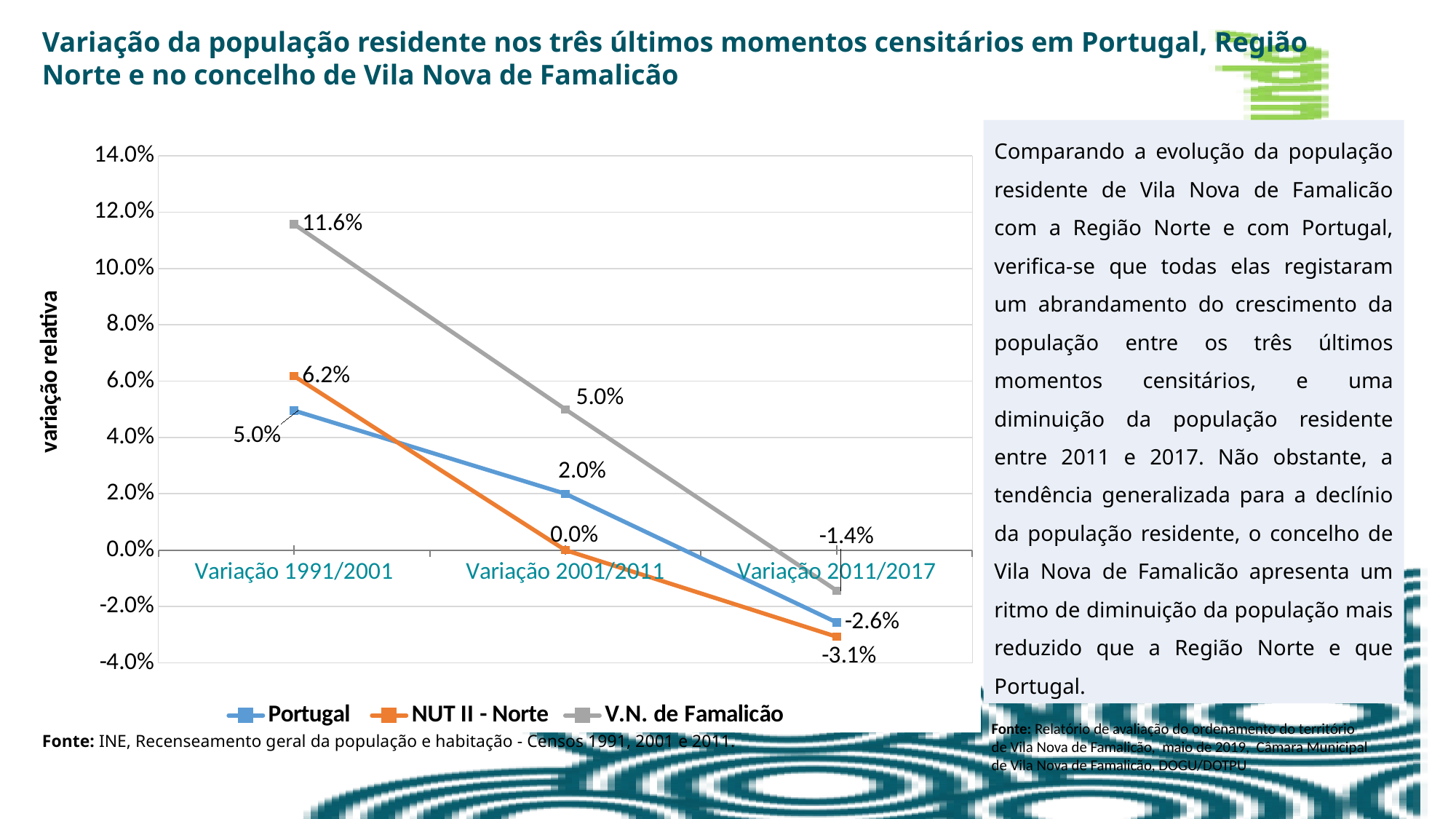
Which series has the highest value in Variação 1991/2001? V.N. de Famalicão Do the values for Portugal rise or fall across the three census periods? fall Which is larger in Variação 2001/2011: Portugal or V.N. de Famalicão? V.N. de Famalicão How many series does the legend list? 3 Which series has the lowest value in Variação 2011/2017? NUT II - Norte What is the label of the y axis? variação relativa What is the difference between V.N. de Famalicão and NUT II - Norte in Variação 1991/2001? 5.4% What is the value for Portugal in Variação 2011/2017? -2.6% What type of chart is shown on the slide? line chart What is the value for NUT II - Norte in Variação 2001/2011? 0.0% How many census periods (categories) are shown on the x axis? 3 What is the value for V.N. de Famalicão in Variação 1991/2001? 11.6%